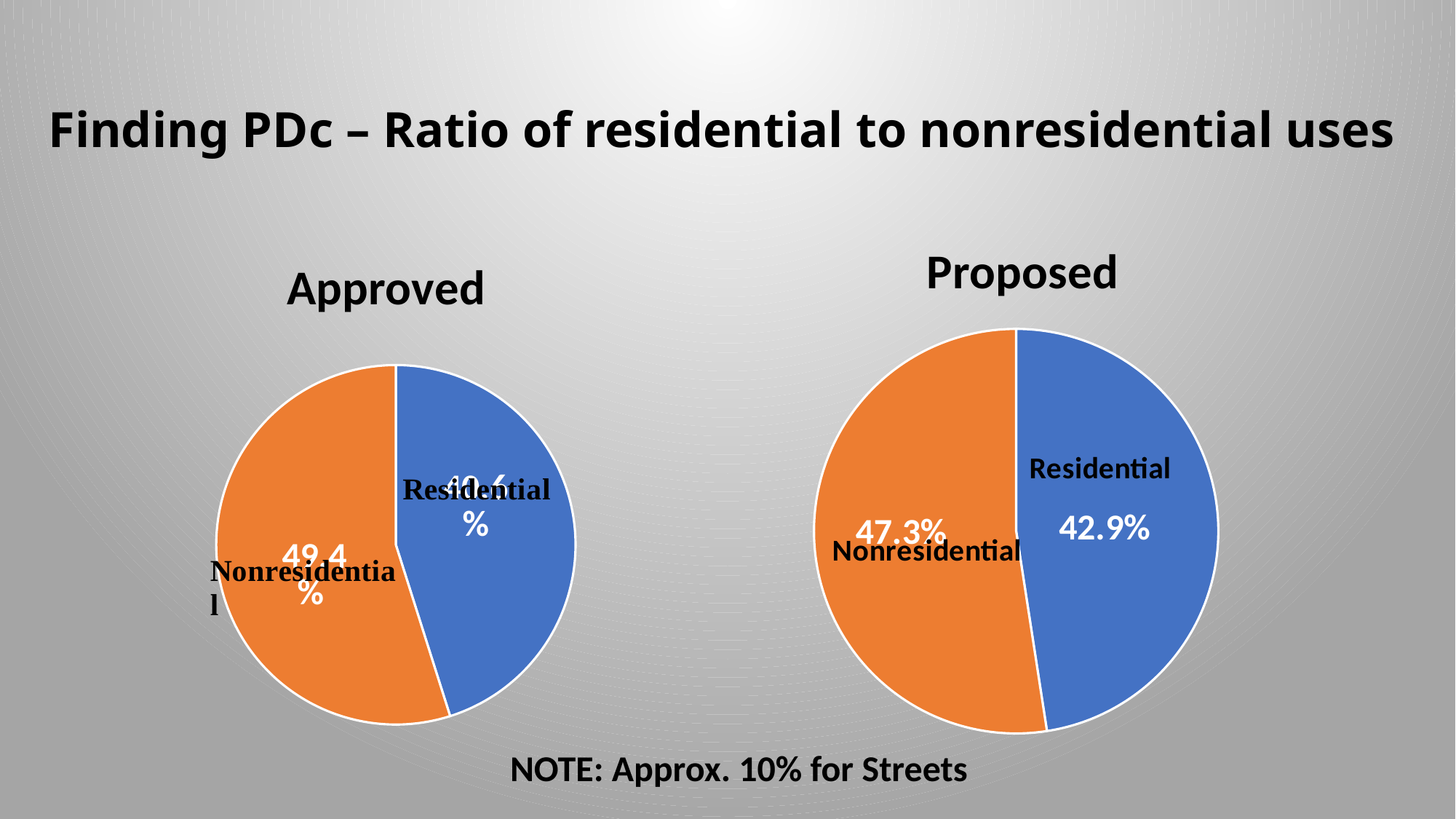
In the Proposed pie chart, what percentage is shown for Residential? 42.9% In the Proposed pie chart, which slice is larger, Residential or Nonresidential? Nonresidential How many slices does the Proposed pie chart have? 2 How many pie charts are shown on the slide? 2 In the Proposed pie chart, what is the difference in percentage points between Nonresidential and Residential? 4.4 In the Approved pie chart, which slice is the smallest? Residential In the Proposed pie chart, what percentage is shown for Nonresidential? 47.3% What colour is the Residential slice in the Proposed pie chart? Blue In the Approved pie chart, which slice is larger, Residential or Nonresidential? Nonresidential What kind of chart is used for the Approved and Proposed data? Pie chart In the Approved pie chart, what percentage is shown for Nonresidential? 49.4% In the Proposed pie chart, which slice is the largest? Nonresidential